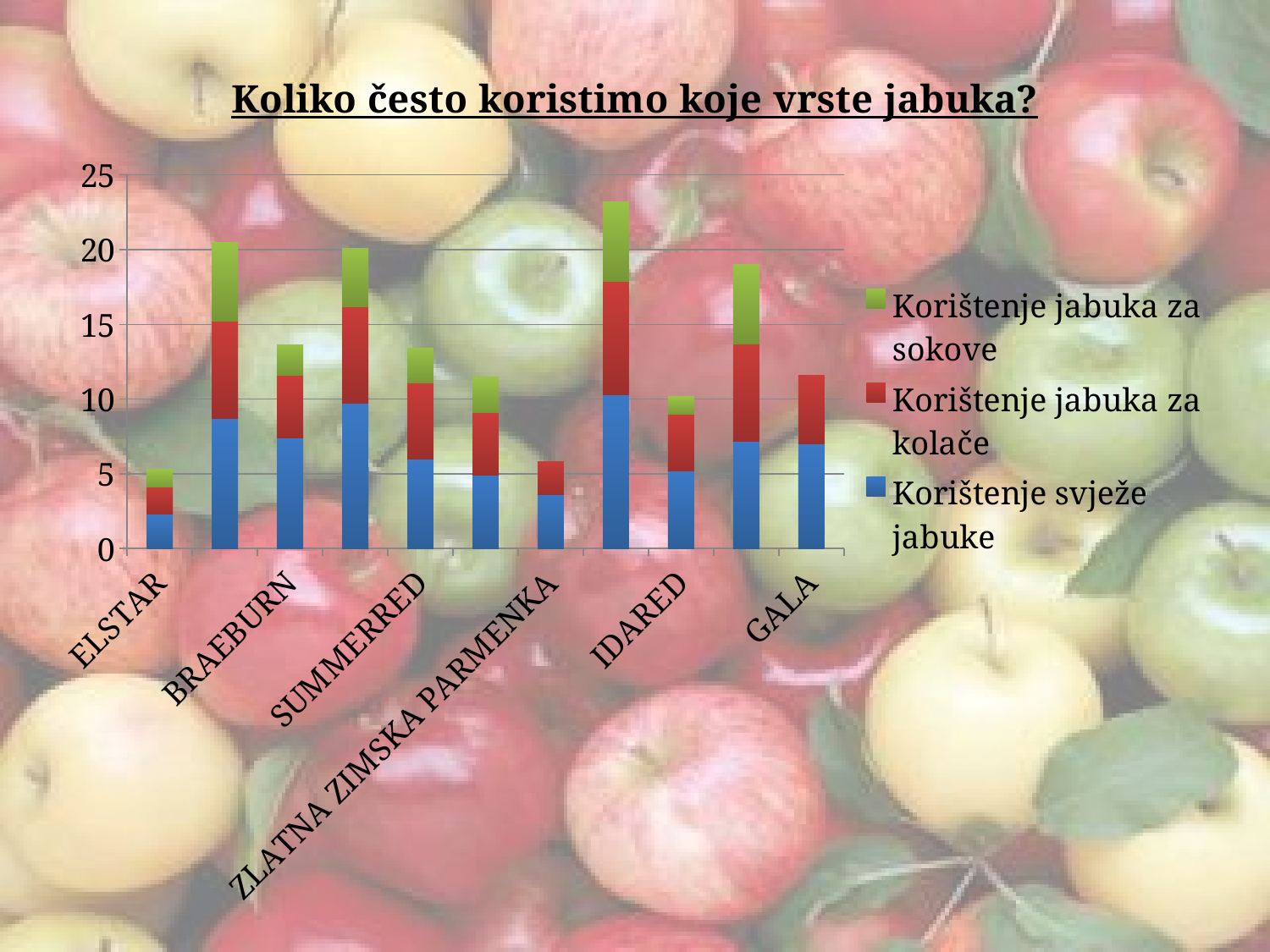
How many bars are plotted in the chart? 11 What kind of chart is shown on the slide? Stacked bar chart Is the total stacked value for BRAEBURN greater or less than 10? greater Which has the larger total stacked value, BRAEBURN or ELSTAR? BRAEBURN What is the title of the chart? Koliko često koristimo koje vrste jabuka? How many series does the legend list? 3 Is the total stacked value for ZLATNA ZIMSKA PARMENKA greater or less than 10? less Which has the larger total stacked value, SUMMERRED or ZLATNA ZIMSKA PARMENKA? SUMMERRED Is the Korištenje svježe jabuke value for ELSTAR greater or less than 5? less Which series is shown in green in the legend? Korištenje jabuka za sokove